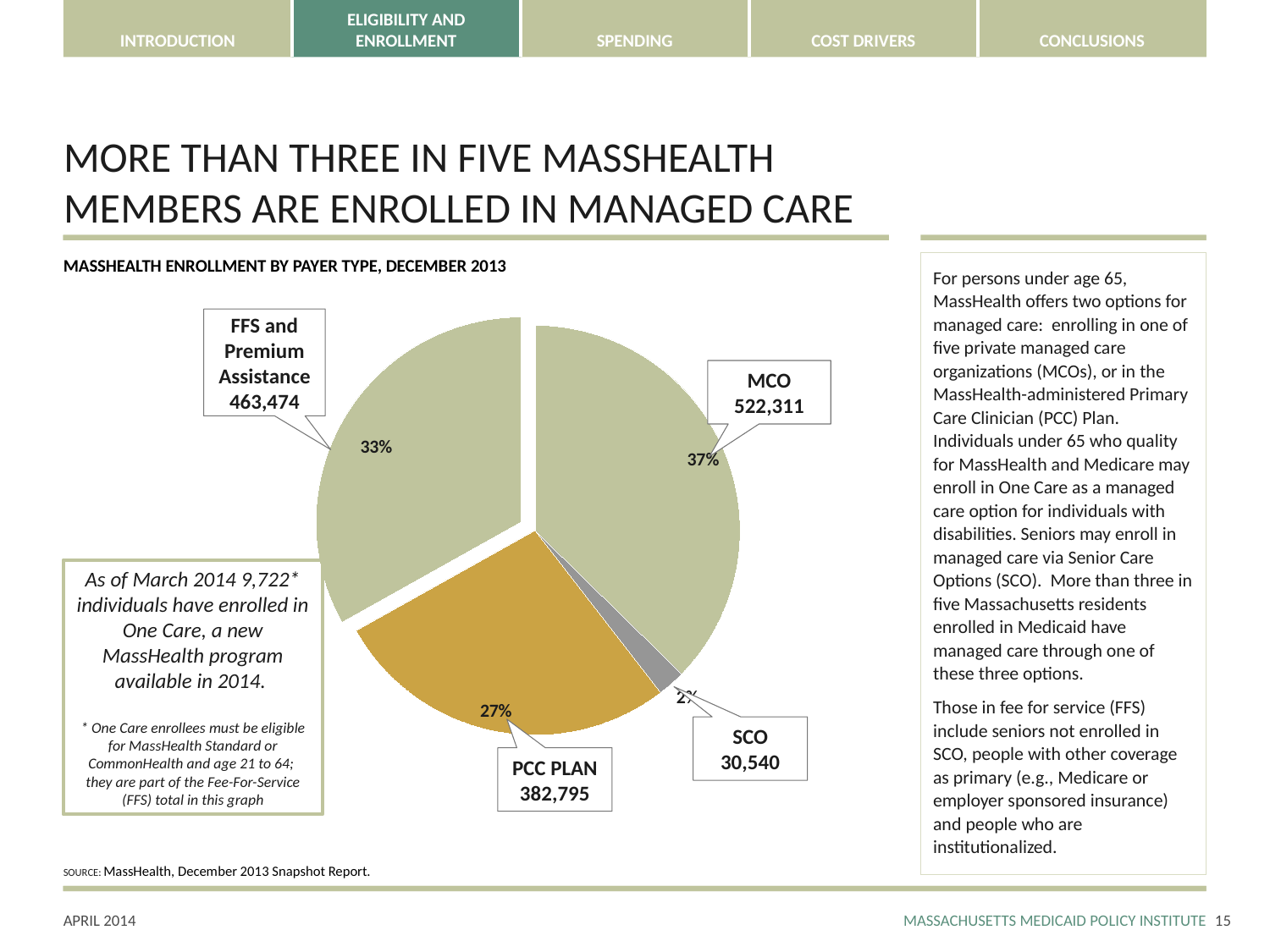
What is the title of the chart? MassHealth Enrollment by Payer Type, December 2013 How many payer types (slices) are shown in the pie chart? 4 What is the enrollment value for the PCC Plan? 382,795 What share of enrollment does the PCC Plan represent? 27% What type of chart is shown on the slide? Pie chart Which payer type has the largest enrollment? MCO What is the enrollment value for MCO? 522,311 What is the difference in enrollment between MCO and FFS and Premium Assistance? 58,837 Which has higher enrollment, FFS and Premium Assistance or the PCC Plan? FFS and Premium Assistance What is the enrollment value for FFS and Premium Assistance? 463,474 Which payer type has the smallest enrollment? SCO What is the enrollment value for SCO? 30,540